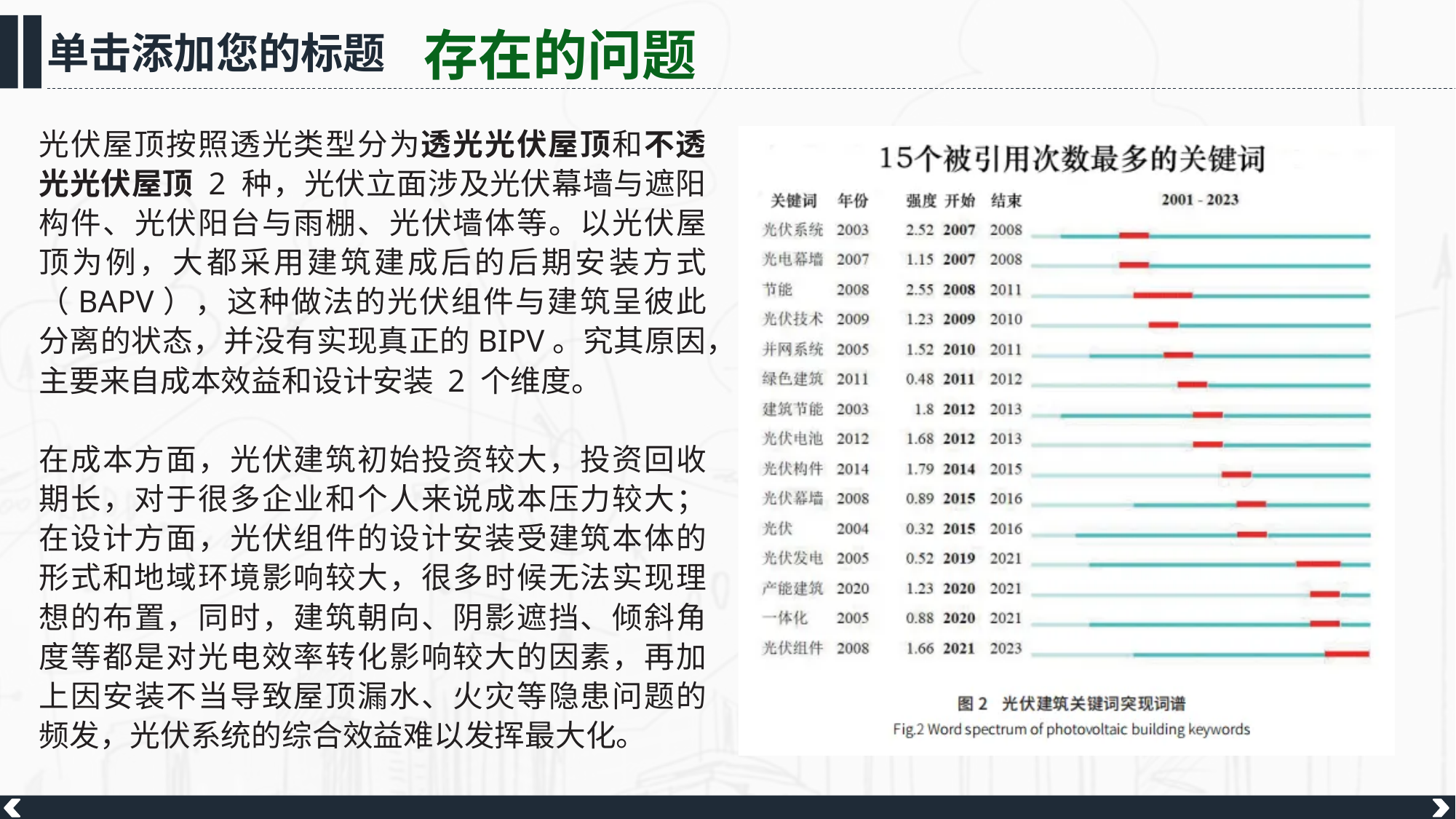
What is the year (年份) listed for the keyword 光伏构件? 2014 In which year does the burst for 光伏组件 end (结束)? 2023 In which year does the burst for 光伏发电 begin (开始)? 2019 What is the burst strength (强度) of the keyword 节能? 2.55 What is the difference in burst strength between 光伏系统 and 光电幕墙? 1.37 What is the title of the chart? 15个被引用次数最多的关键词 What time span is shown at the top of the timeline bars? 2001 - 2023 How many keywords are listed in the chart? 15 Which keyword has the lowest burst strength (强度)? 光伏 Is the burst strength of 并网系统 greater or less than 1? greater Which keyword has the highest burst strength (强度)? 节能 Which has a higher burst strength, 建筑节能 or 光伏电池? 建筑节能